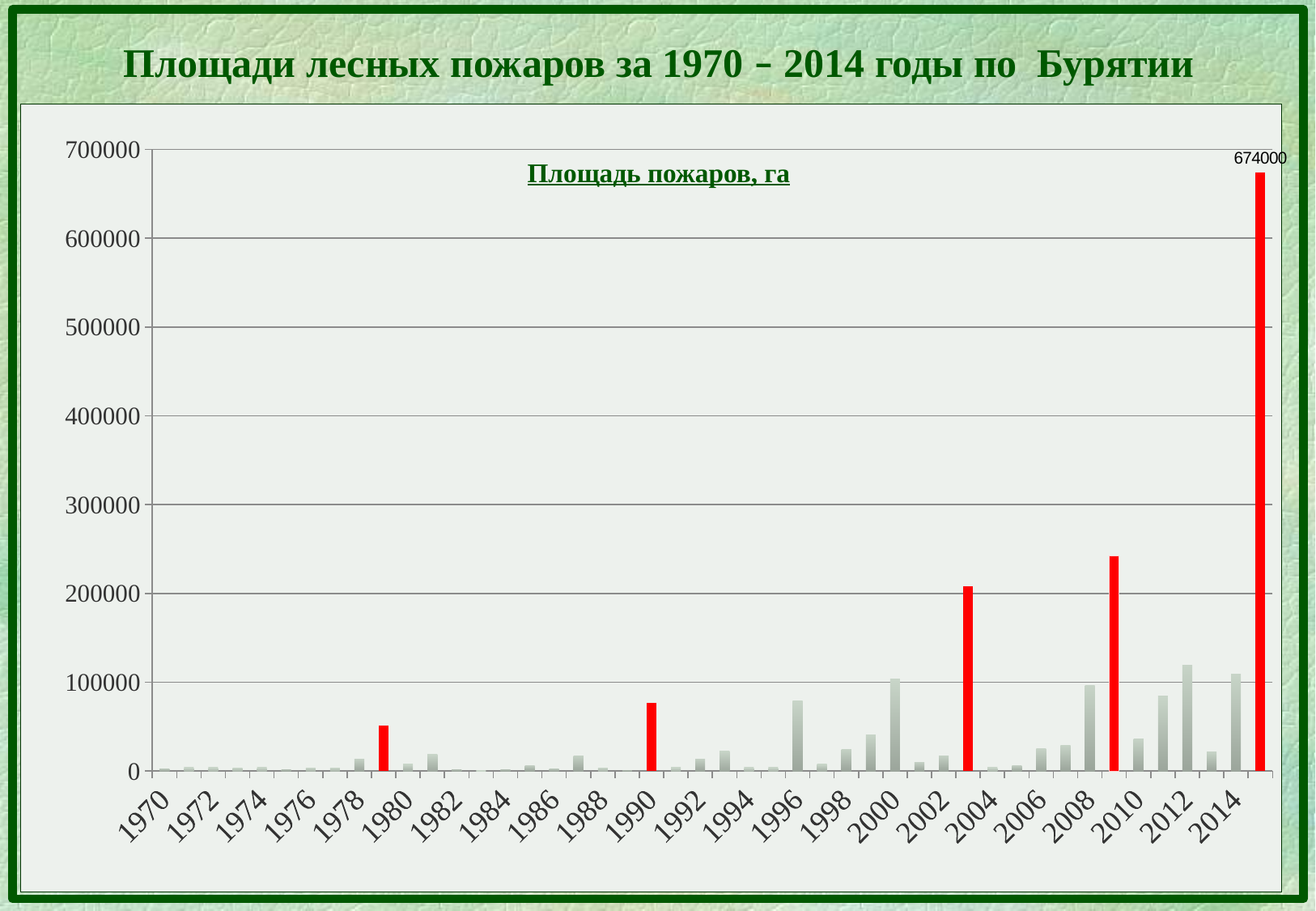
Is the value for 2012 greater or less than 100000? greater Is the value for 2009 greater or less than 200000? greater What is the name of the data series shown above the plot area? Площадь пожаров, га How many bars are highlighted in red? 5 Is the value for 1996 greater or less than 100000? less What is the highest value shown on the vertical axis? 700000 Overall, do the fire areas tend to rise or fall from 1970 to the end of the period? rise What value is printed as the data label on the tallest bar? 674000 What kind of chart is shown on the slide? bar chart Which is larger, the value for 2012 or the value for 2010? 2012 Which is larger, the value for 2009 or the value for 2003? 2009